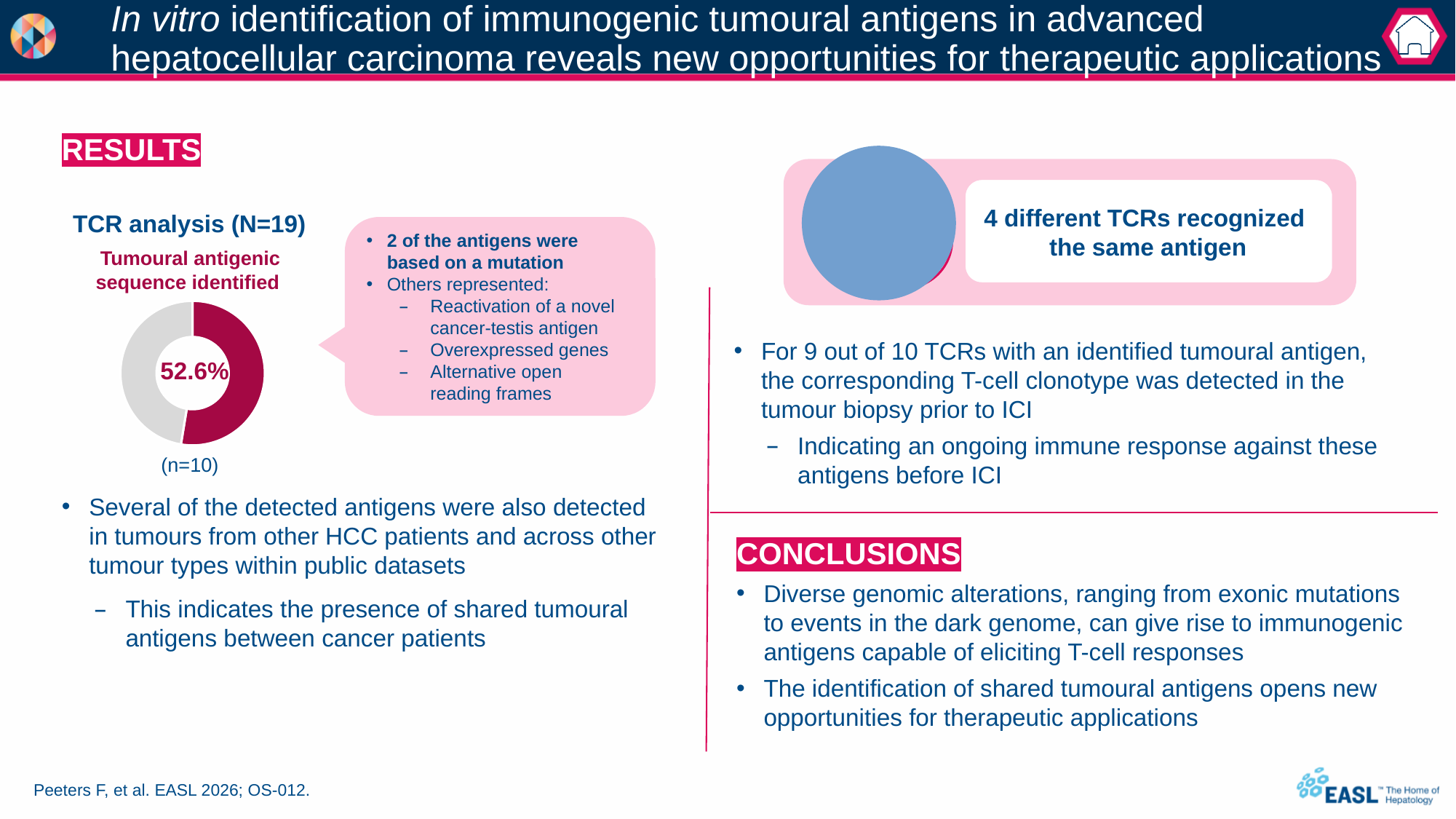
Is the share of TCRs with a tumoural antigenic sequence identified greater or less than 50%? greater What kind of chart is shown under 'Tumoural antigenic sequence identified'? pie chart (donut) What is the total N for the TCR analysis that the donut chart belongs to? 19 In the donut chart, which is larger: the slice for tumoural antigenic sequence identified or the remaining slice? tumoural antigenic sequence identified How many slices does the donut chart have? 2 What colour is the slice representing the 52.6% in the donut chart? dark red What is the n value shown below the donut chart for the tumoural antigenic sequence identified? n=10 What percentage is printed in the centre of the donut chart? 52.6% What is the title printed above the donut chart? Tumoural antigenic sequence identified